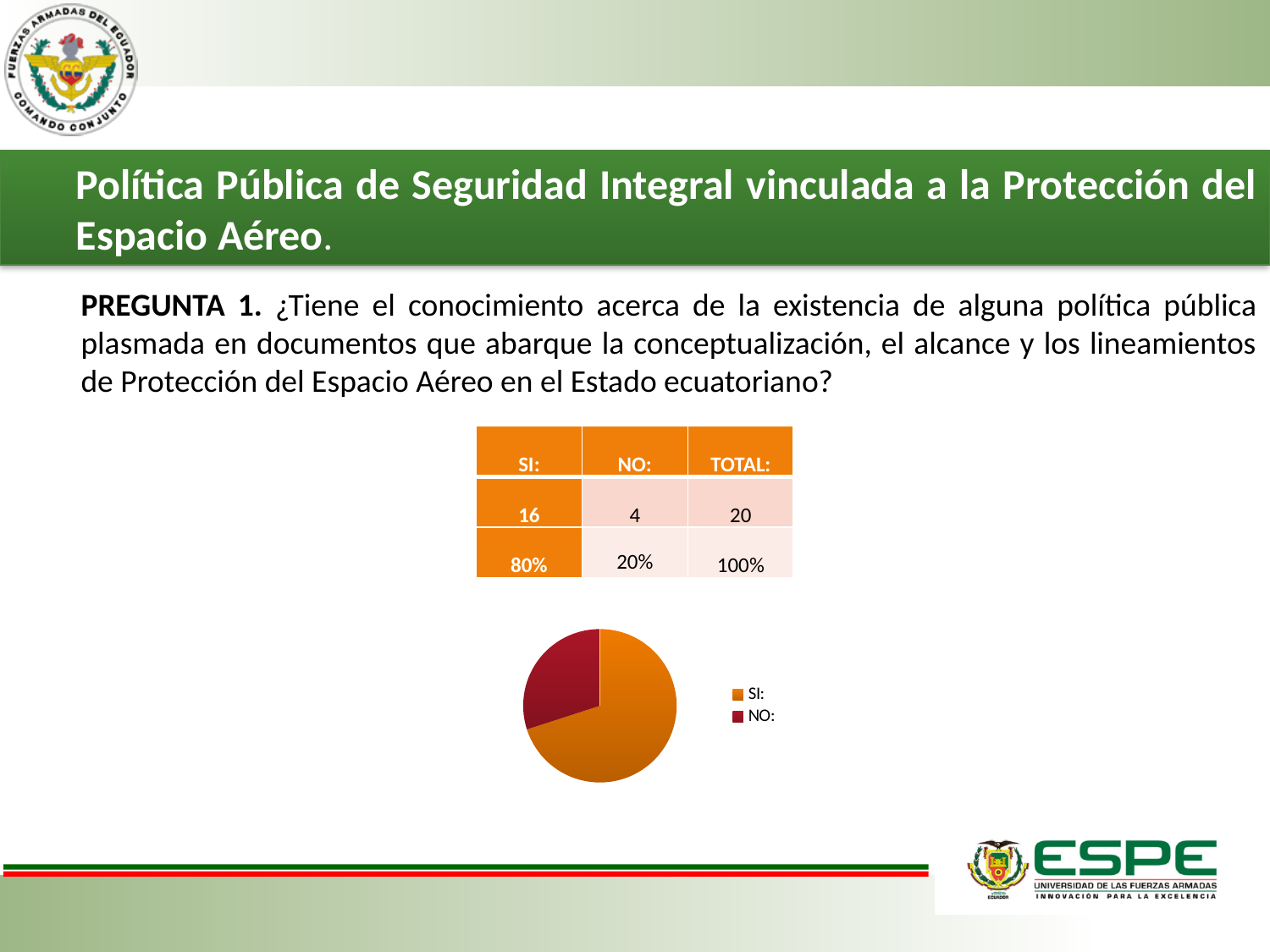
According to the table above the pie chart, what is the count for NO:? 4 Which category has the smallest slice in the pie chart? NO: What share of the pie does the SI: slice represent, as shown in the table? 80% What share of the pie does the NO: slice represent, as shown in the table? 20% How many entries does the pie chart's legend list? 2 According to the table above the pie chart, what is the count for SI:? 16 How many slices does the pie chart have? 2 What colour is the SI: slice in the pie chart? orange What is the difference between the SI: count and the NO: count shown in the table? 12 Which category has the largest slice in the pie chart? SI: Which slice is larger in the pie chart, SI: or NO:? SI: What kind of chart is shown on the slide? pie chart